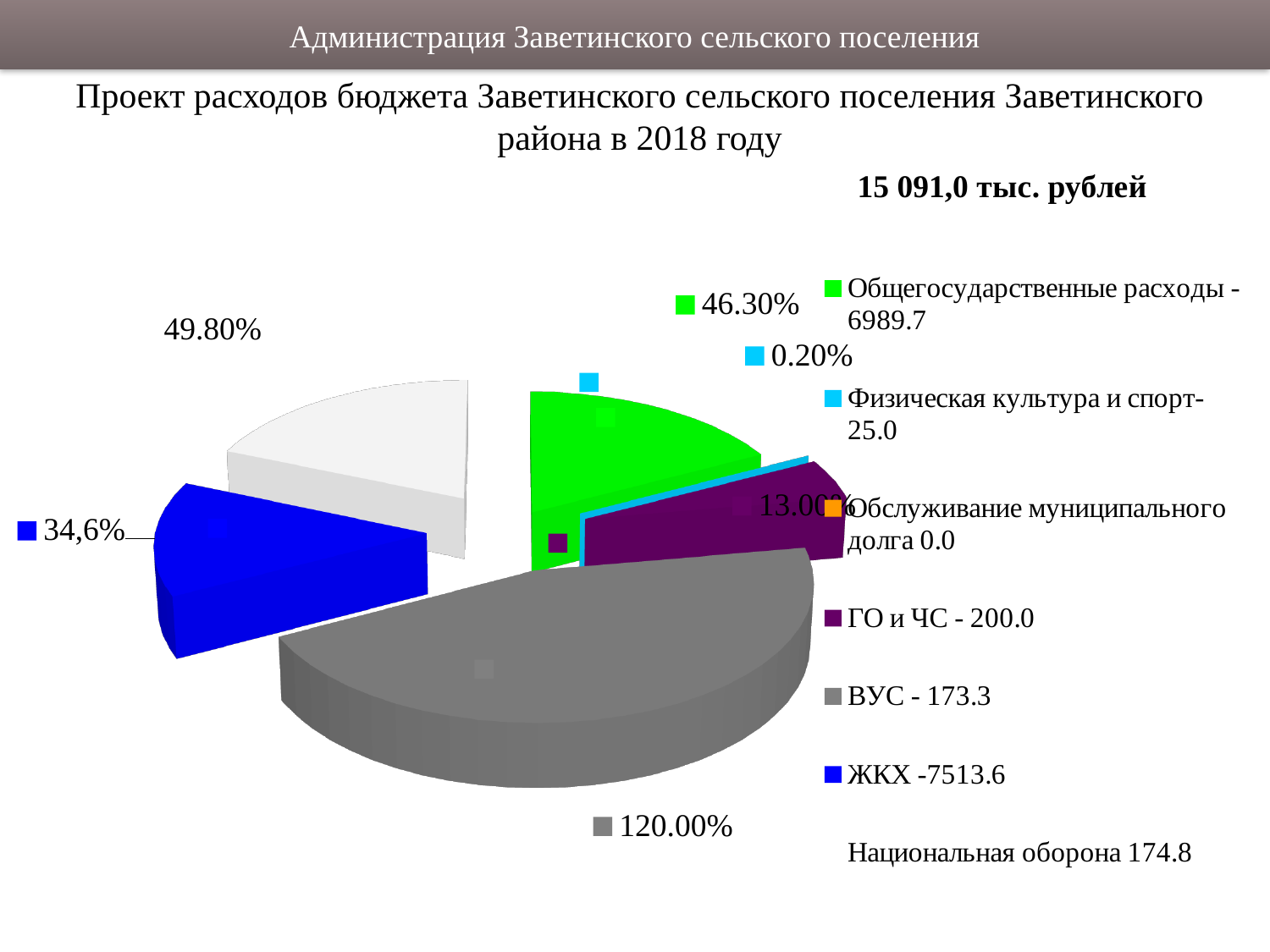
What value is given in the legend for ГО и ЧС? 200.0 What kind of chart is shown on the slide? pie chart Which legend entry has the largest value? ЖКХ What value is given in the legend for Общегосударственные расходы? 6989.7 What percentage label is shown on the green slice? 46.30% What value is given in the legend for ЖКХ? 7513.6 Which has the larger legend value, ВУС or Национальная оборона? Национальная оборона What value is given in the legend for Физическая культура и спорт? 25.0 What is the difference between the legend values for ЖКХ and Общегосударственные расходы? 523.9 Which legend entry has the smallest value? Обслуживание муниципального долга What total amount is printed above the chart? 15 091,0 тыс. рублей How many entries does the chart legend list? 7